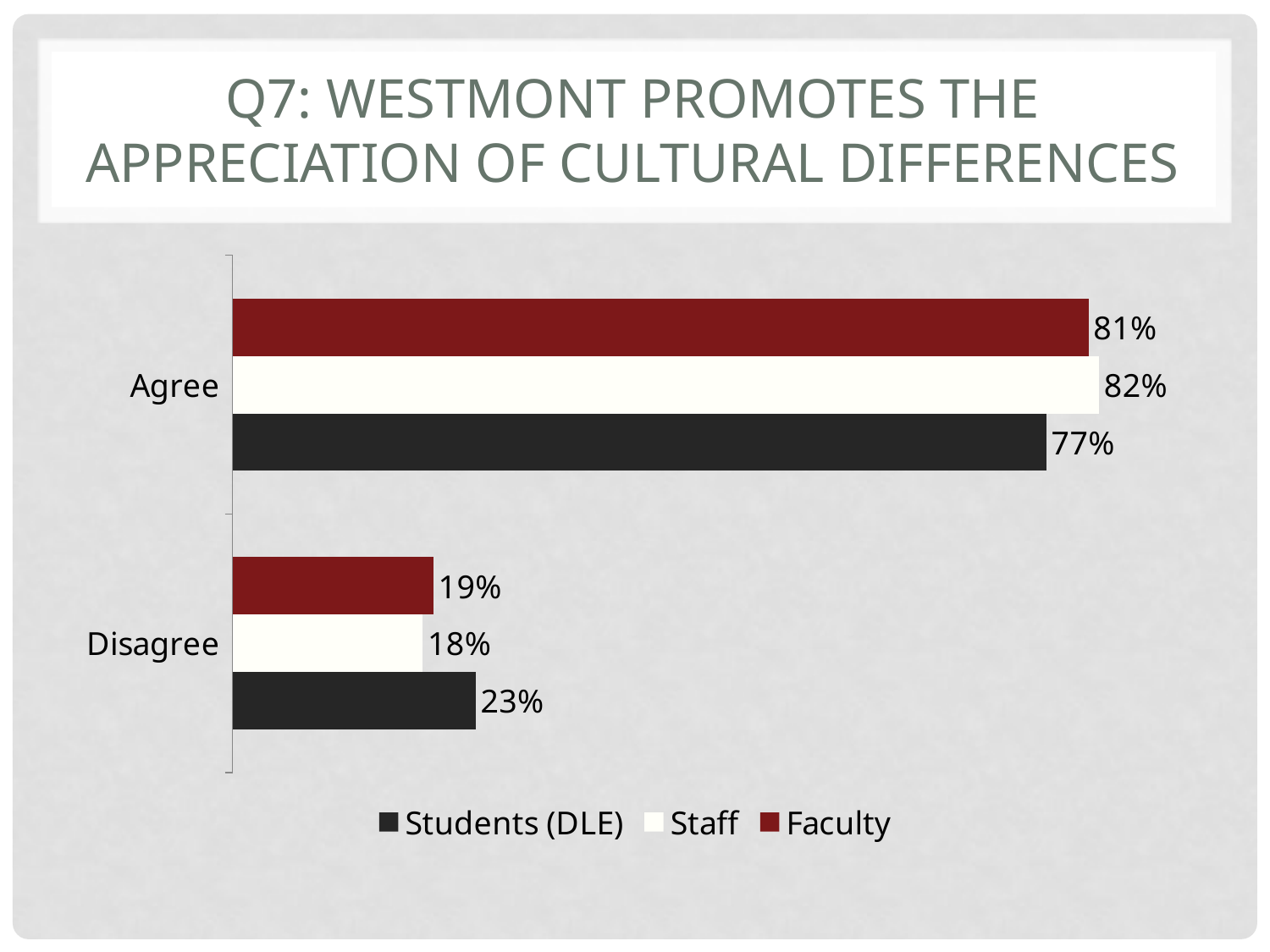
Which group has the highest Agree percentage? Staff What percentage of Staff disagree? 18% What percentage of Staff agree? 82% What percentage of Students (DLE) disagree? 23% How many series does the legend list? 3 What kind of chart is shown on the slide? Bar chart Which is larger: the Disagree percentage for Students (DLE) or for Faculty? Students (DLE) What is the difference between the Staff and Students (DLE) Agree percentages? 5% Which series is shown in dark red? Faculty Which group has the lowest Agree percentage? Students (DLE) What percentage of Faculty agree that Westmont promotes the appreciation of cultural differences? 81% How many response categories are shown on the chart? 2